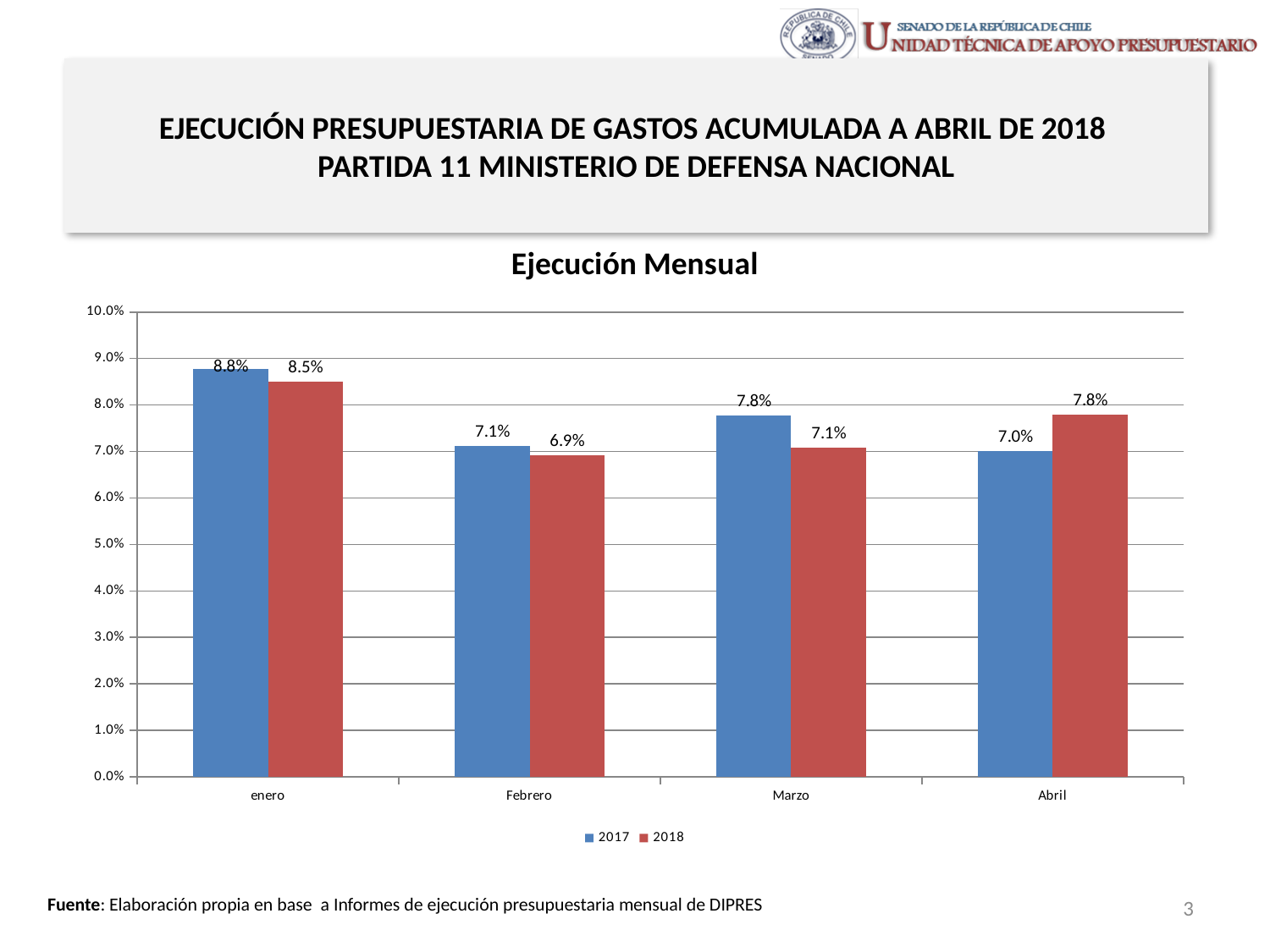
Which month has the highest value for the 2017 series? enero What is the value for 2017 in Marzo? 7.8% Which month has the lowest value for the 2018 series? Febrero What is the value for 2018 in Abril? 7.8% What is the title of the chart? Ejecución Mensual What kind of chart is shown? bar chart What is the value for 2018 in Febrero? 6.9% What is the value for 2017 in enero? 8.8% How many series does the legend list? 2 How many months are shown on the x axis? 4 What is the difference between the 2017 and 2018 values in Abril? 0.8% Which is larger in Marzo, the 2017 value or the 2018 value? 2017